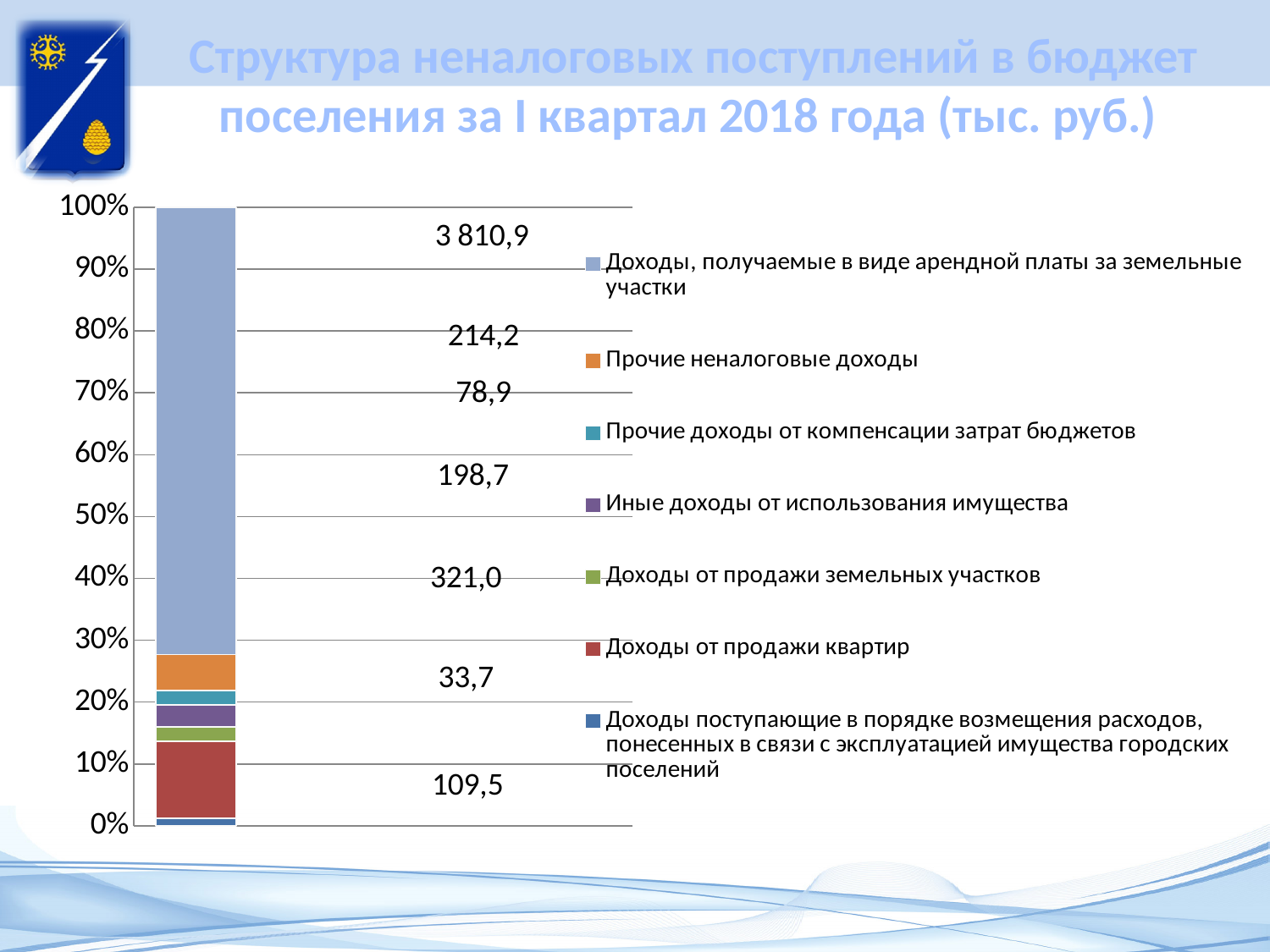
What type of chart is shown on the slide? stacked bar chart What is the value labelled for 'Прочие неналоговые доходы'? 214,2 What is the title of the chart on the slide? Структура неналоговых поступлений в бюджет поселения за I квартал 2018 года (тыс. руб.) How many bars are plotted in the chart? 1 What is the difference between the labelled values 3 810,9 and 214,2? 3 596,7 Which series has the highest labelled value? Доходы, получаемые в виде арендной платы за земельные участки How many series does the legend list? 7 What is the value labelled for 'Прочие доходы от компенсации затрат бюджетов'? 78,9 What is the total of all seven labelled values in the bar? 4 766,9 What is the value labelled for 'Доходы поступающие в порядке возмещения расходов, понесенных в связи с эксплуатацией имущества городских поселений'? 109,5 What is the value labelled for 'Доходы, получаемые в виде арендной платы за земельные участки'? 3 810,9 What is the value labelled for 'Доходы от продажи земельных участков'? 321,0